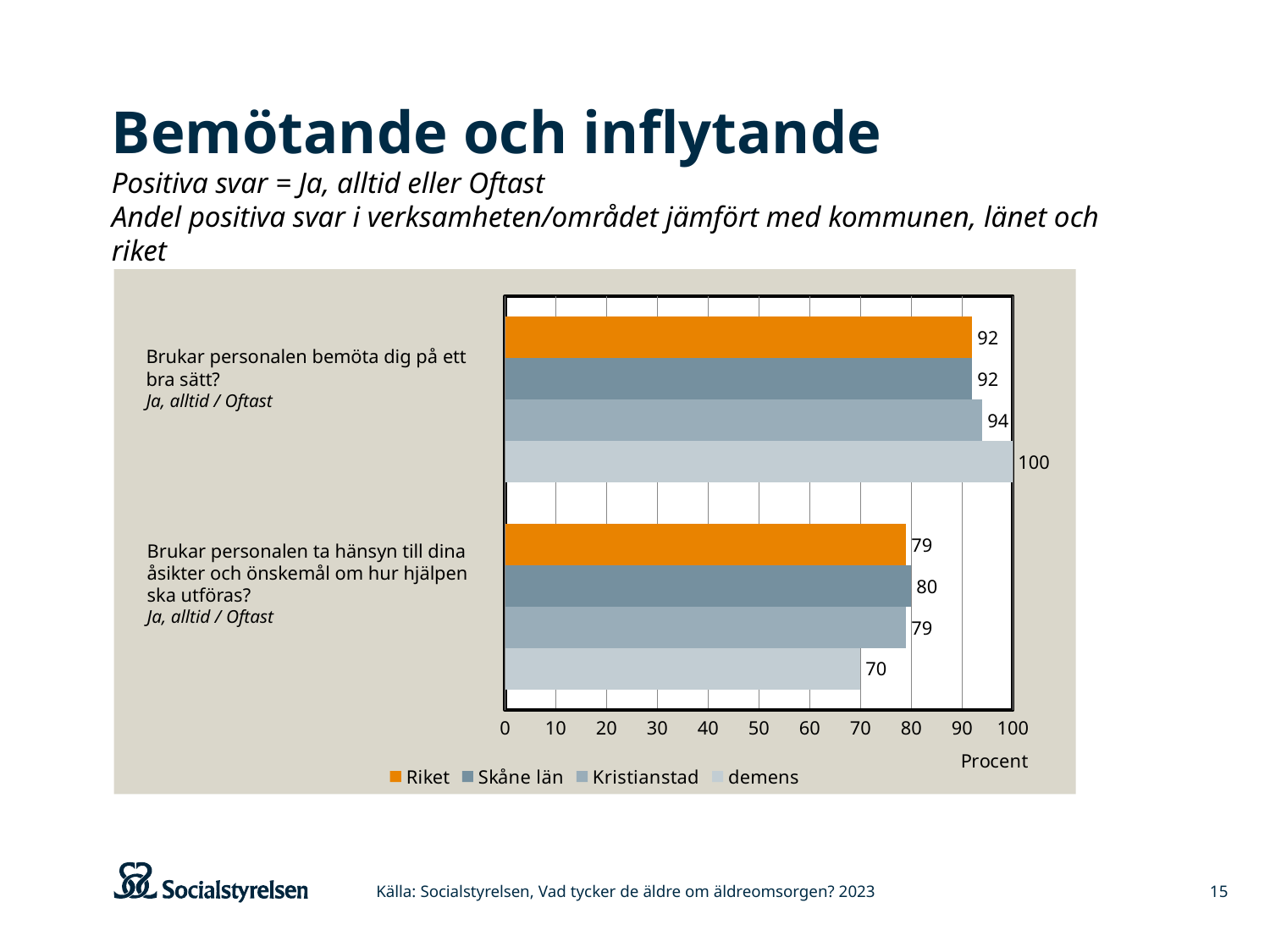
What is the label of the x axis? Procent What is the value for Riket for the question "Brukar personalen ta hänsyn till dina åsikter och önskemål om hur hjälpen ska utföras?"? 79 For demens, which question has the larger value: "Brukar personalen bemöta dig på ett bra sätt?" or "Brukar personalen ta hänsyn till dina åsikter och önskemål om hur hjälpen ska utföras?"? Brukar personalen bemöta dig på ett bra sätt? What is the value for Kristianstad for the question "Brukar personalen bemöta dig på ett bra sätt?"? 94 What is the difference between the demens value and the Riket value for the question "Brukar personalen bemöta dig på ett bra sätt?"? 8 What kind of chart is shown on the slide? Bar chart How many series does the legend list? 4 What is the value for demens for the question "Brukar personalen bemöta dig på ett bra sätt?"? 100 Which series has the lowest value for the question "Brukar personalen ta hänsyn till dina åsikter och önskemål om hur hjälpen ska utföras?"? demens What is the value for Skåne län for the question "Brukar personalen ta hänsyn till dina åsikter och önskemål om hur hjälpen ska utföras?"? 80 Which series has the highest value for the question "Brukar personalen bemöta dig på ett bra sätt?"? demens What is the difference between the Skåne län value and the demens value for the question "Brukar personalen ta hänsyn till dina åsikter och önskemål om hur hjälpen ska utföras?"? 10